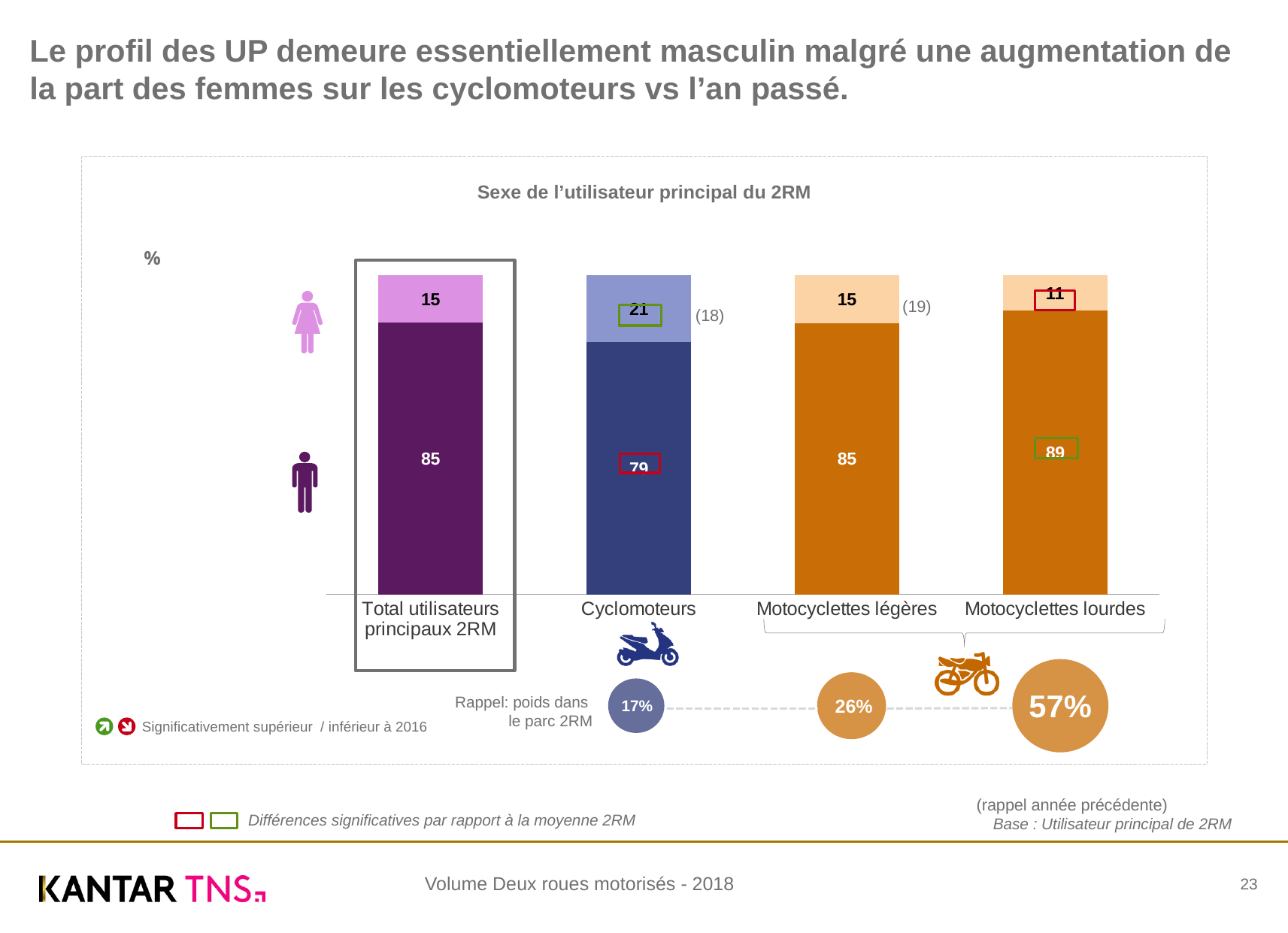
What is the male share for Motocyclettes lourdes? 89 What is the female share for Cyclomoteurs? 21 What kind of chart is shown on the slide? Stacked bar chart What is the male share for Total utilisateurs principaux 2RM? 85 What is the difference between the male share for Motocyclettes lourdes and the male share for Cyclomoteurs? 10 What is the female share for Motocyclettes légères? 15 Is the male share larger for Cyclomoteurs or for Motocyclettes légères? Motocyclettes légères Which category has the highest female share? Cyclomoteurs How many categories are shown on the x axis of the chart? 4 What was the previous year's female share for Cyclomoteurs, shown in parentheses? (18) Which category has the lowest female share? Motocyclettes lourdes What is the title of the chart? Sexe de l'utilisateur principal du 2RM